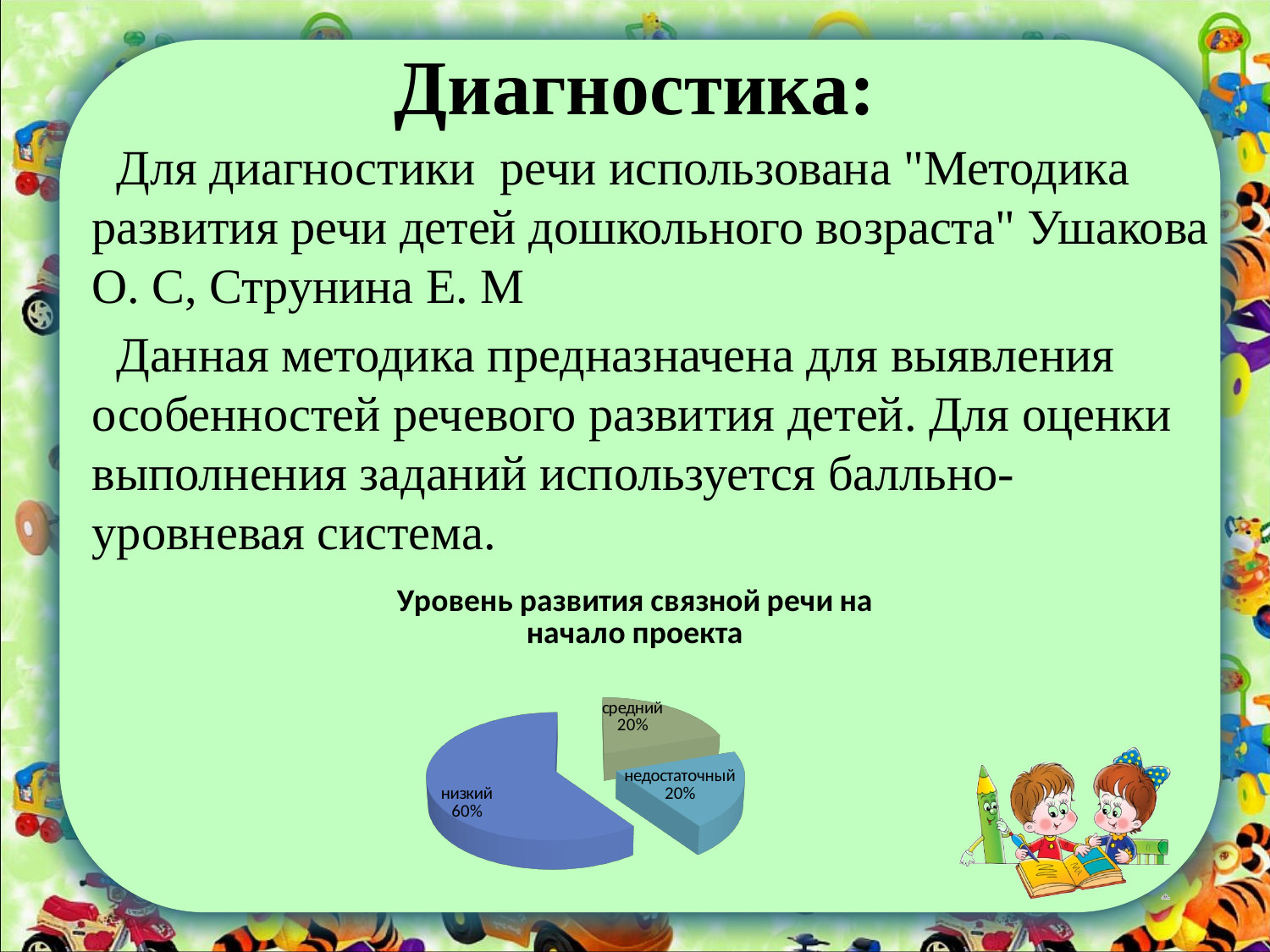
Which two categories have equal shares of the pie? средний and недостаточный What is the value shown for "средний"? 20% What is the value shown for "недостаточный"? 20% What is the difference between the "низкий" and "недостаточный" values? 40% What kind of chart is shown on the slide? pie chart What is the title of the chart? Уровень развития связной речи на начало проекта What colour is the "низкий" slice? blue What share of the pie does the "низкий" slice take? 60% Which is larger, the slice for "низкий" or the slice for "средний"? низкий How many slices does the pie chart have? 3 Which category has the largest slice of the pie? низкий Is the value for "низкий" greater or less than 50%? greater